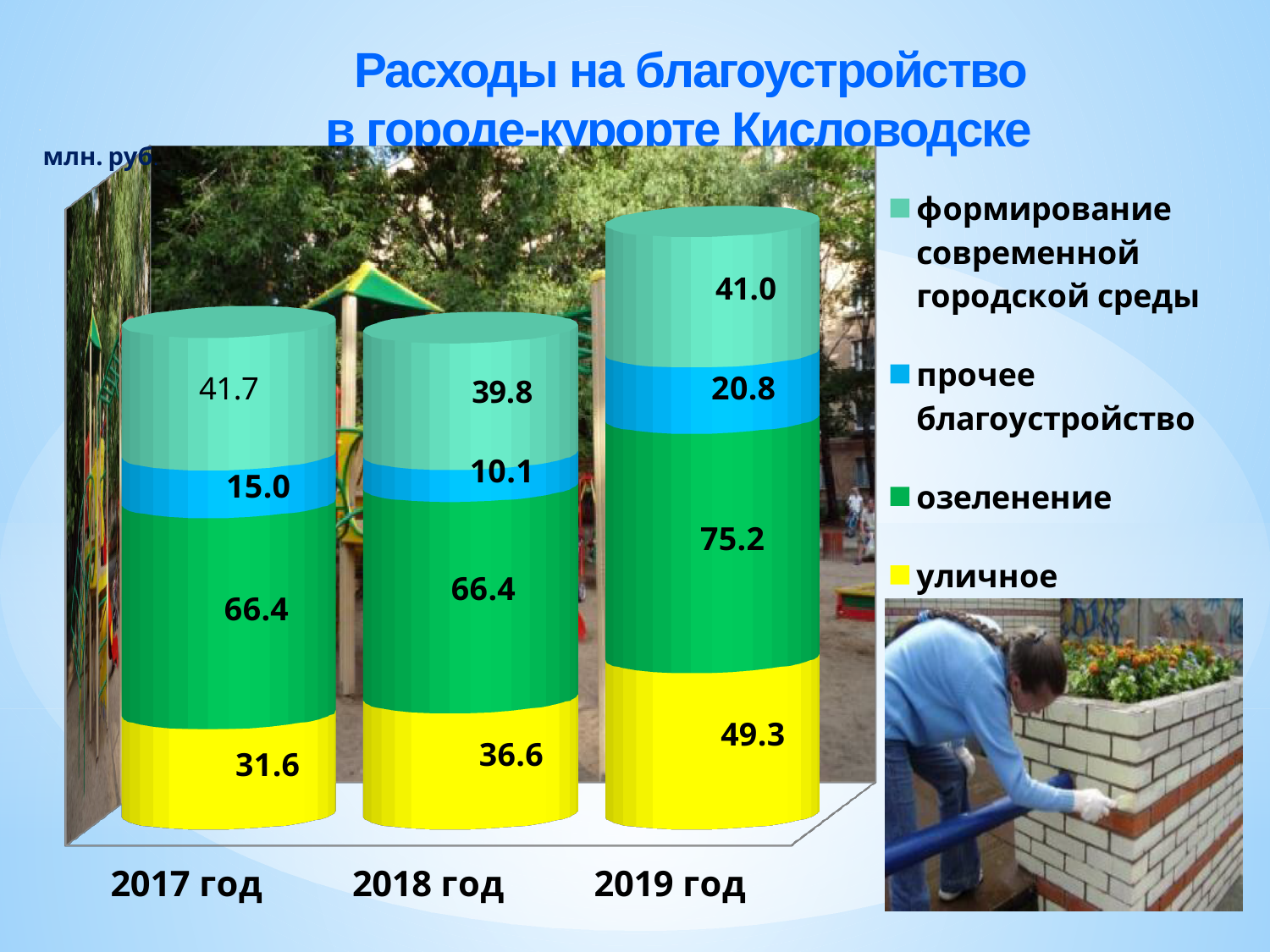
What is the value for озеленение in 2018 год? 66.4 In which year is the value for прочее благоустройство the lowest? 2018 год How many years are shown on the x axis? 3 Which is larger: уличное in 2017 год or уличное in 2018 год? 2018 год In which year is the value for уличное the highest? 2019 год What is the value for прочее благоустройство in 2017 год? 15.0 What is the total of the stacked bar for 2019 год? 186.3 What is the value for уличное in 2019 год? 49.3 What is the difference between the озеленение values for 2019 год and 2018 год? 8.8 How many series does the legend list? 4 What is the value for формирование современной городской среды in 2018 год? 39.8 What kind of chart is shown on the slide? Stacked bar chart